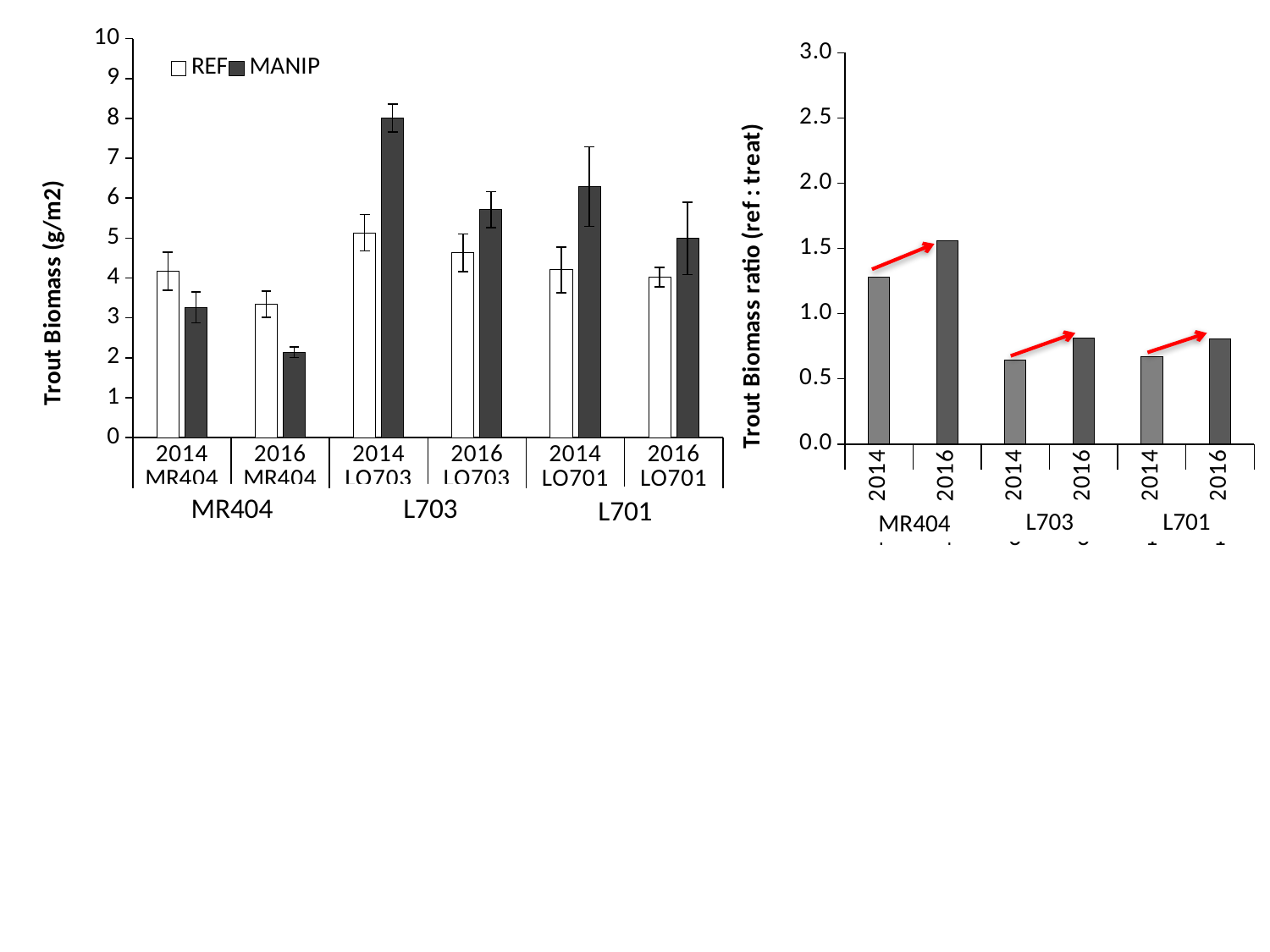
In the right chart (Trout Biomass ratio), which bar is the highest? 2016 MR404 In the left chart (Trout Biomass), is the MANIP value for 2016 MR404 greater or less than 3? less In the left chart (Trout Biomass), what are the two series named in the legend? REF and MANIP In the left chart (Trout Biomass), which is larger for 2014 MR404: REF or MANIP? REF In the left chart (Trout Biomass), is the MANIP value for 2014 L703 greater or less than 7? greater What kind of chart is the left chart (Trout Biomass)? bar chart In the left chart (Trout Biomass), how many series does the legend list? 2 In the left chart (Trout Biomass), which bar is the highest? MANIP, 2014 L703 In the left chart (Trout Biomass), which is larger for 2016 L703: REF or MANIP? MANIP In the left chart (Trout Biomass), which bar is the lowest? MANIP, 2016 MR404 In the right chart (Trout Biomass ratio), is the value for 2016 L703 greater or less than 1.0? less In the right chart (Trout Biomass ratio), how many bars are plotted? 6